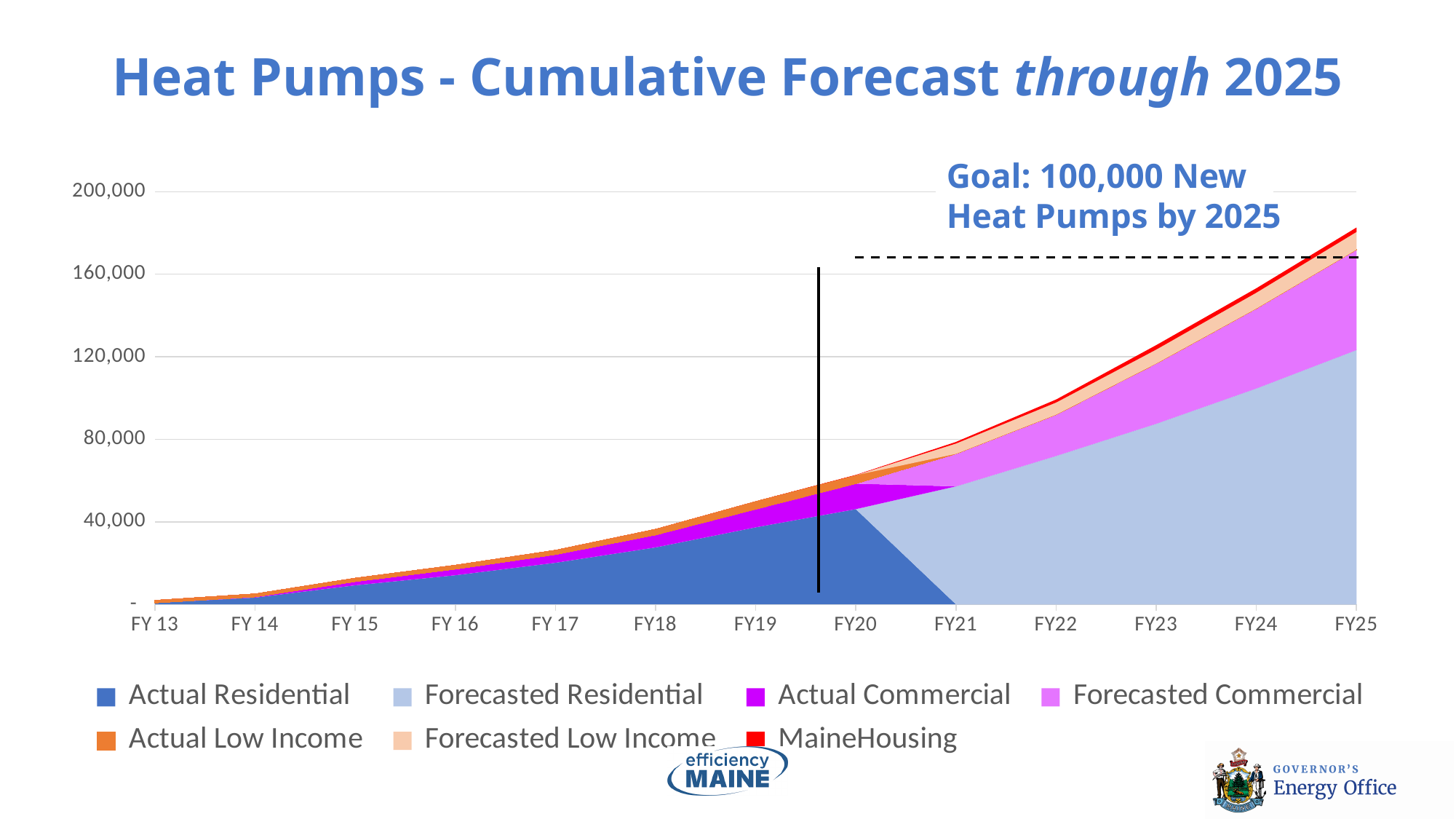
What goal is stated on the chart? 100,000 New Heat Pumps by 2025 Is the cumulative total for FY22 greater or less than 80,000? greater Is the cumulative total for FY25 greater or less than 160,000? greater What is the title of the chart? Heat Pumps - Cumulative Forecast through 2025 What kind of chart is shown on the slide? Stacked area chart How many fiscal years are shown along the x axis? 13 How many series does the legend list? 7 Is the cumulative total for FY20 greater or less than 80,000? less Do the cumulative totals rise or fall from FY 13 to FY25? Rise Which fiscal year has the highest cumulative total? FY25 Which fiscal year has the lowest cumulative total? FY 13